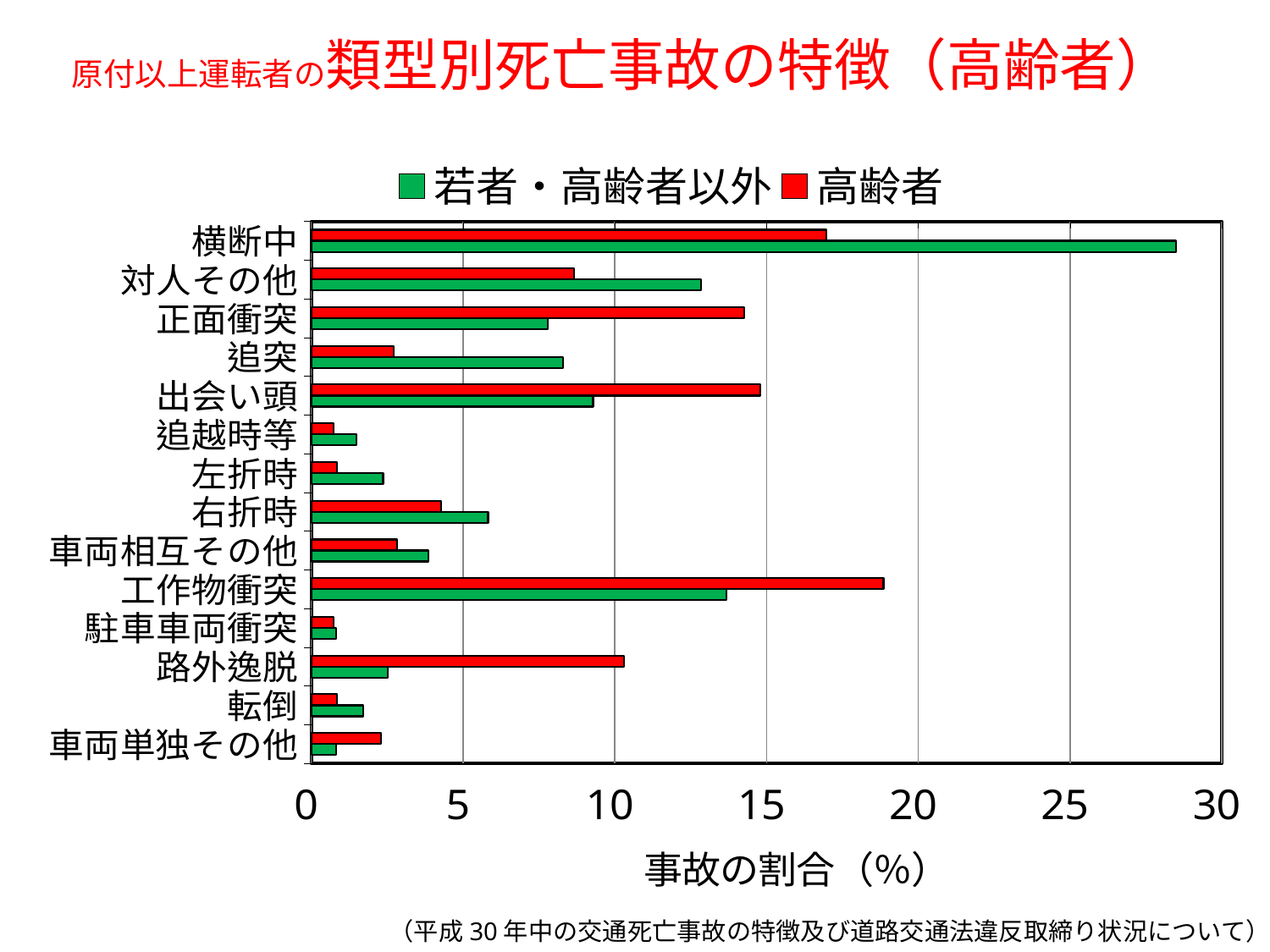
Is the 高齢者 value for 工作物衝突 greater or less than 15? greater How many accident categories are plotted on the chart? 14 For 横断中, which series has the larger value, 若者・高齢者以外 or 高齢者? 若者・高齢者以外 Which category has the highest value for the 高齢者 series? 工作物衝突 What is the label of the horizontal axis? 事故の割合（%） How many series does the legend list? 2 Which category has the highest value for the 若者・高齢者以外 series? 横断中 What kind of chart is shown on the slide? bar chart For 正面衝突, which series has the larger value, 若者・高齢者以外 or 高齢者? 高齢者 Is the 高齢者 value for 路外逸脱 greater or less than 5? greater Is the 高齢者 value for 追突 greater or less than 5? less